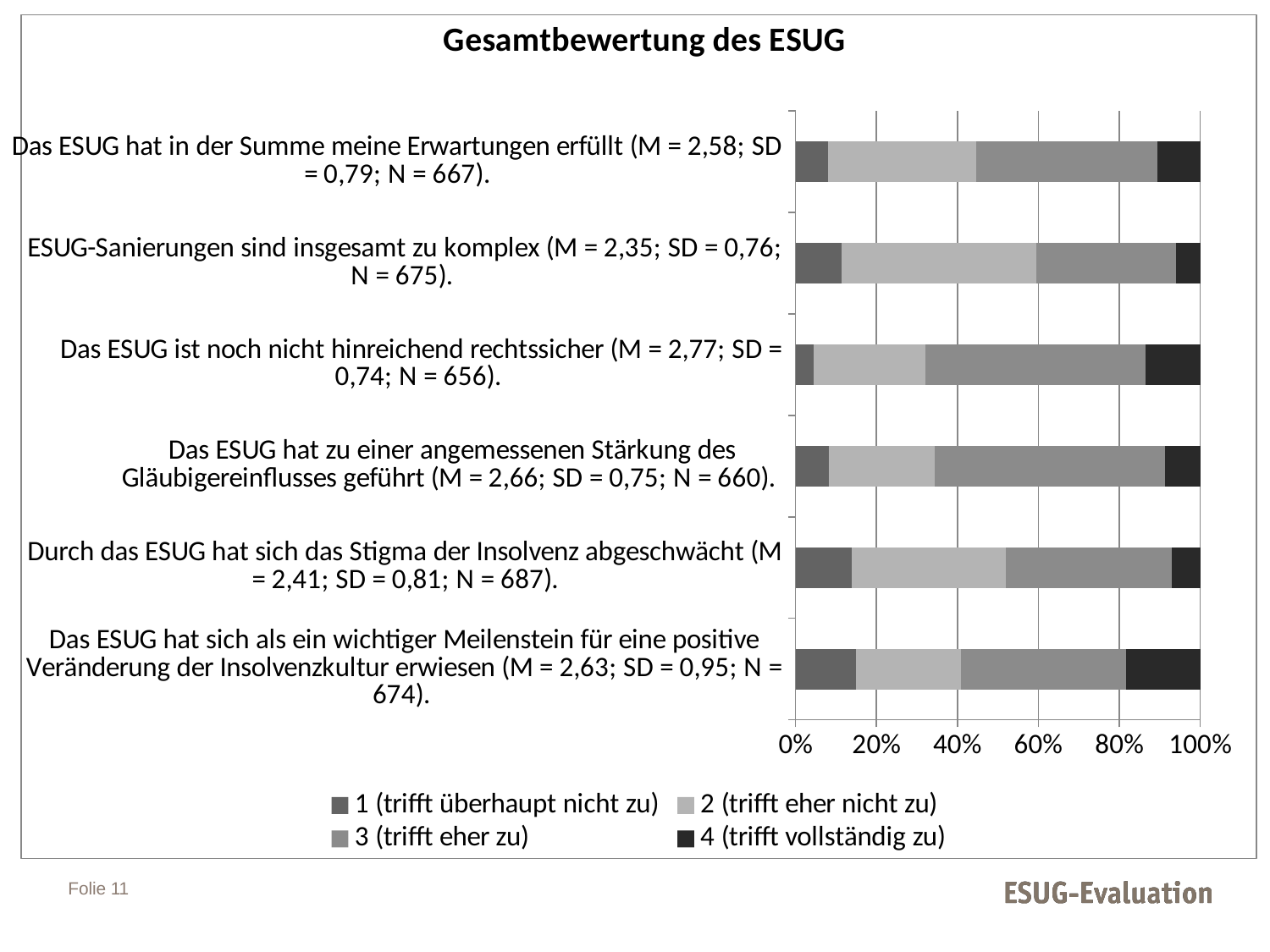
Is the share of '1 (trifft überhaupt nicht zu)' for 'Das ESUG hat sich als ein wichtiger Meilenstein für eine positive Veränderung der Insolvenzkultur erwiesen' greater or less than 20%? less What is the N given for the statement 'ESUG-Sanierungen sind insgesamt zu komplex'? 675 Which legend entry is shown in the darkest (black) colour? 4 (trifft vollständig zu) What kind of chart is shown on the slide? Stacked bar chart What is the mean (M) given for the statement 'Das ESUG hat zu einer angemessenen Stärkung des Gläubigereinflusses geführt'? 2,66 What is the title of the chart? Gesamtbewertung des ESUG Which statement has the highest mean (M) shown in its label? Das ESUG ist noch nicht hinreichend rechtssicher Which statement has the larger share of '1 (trifft überhaupt nicht zu)': 'Das ESUG ist noch nicht hinreichend rechtssicher' or 'Das ESUG hat sich als ein wichtiger Meilenstein für eine positive Veränderung der Insolvenzkultur erwiesen'? Das ESUG hat sich als ein wichtiger Meilenstein für eine positive Veränderung der Insolvenzkultur erwiesen Which statement has the lowest mean (M) shown in its label? ESUG-Sanierungen sind insgesamt zu komplex How many statements (categories) are plotted in the chart? 6 Is the share of '2 (trifft eher nicht zu)' for 'ESUG-Sanierungen sind insgesamt zu komplex' greater or less than 40%? greater How many series does the legend list? 4